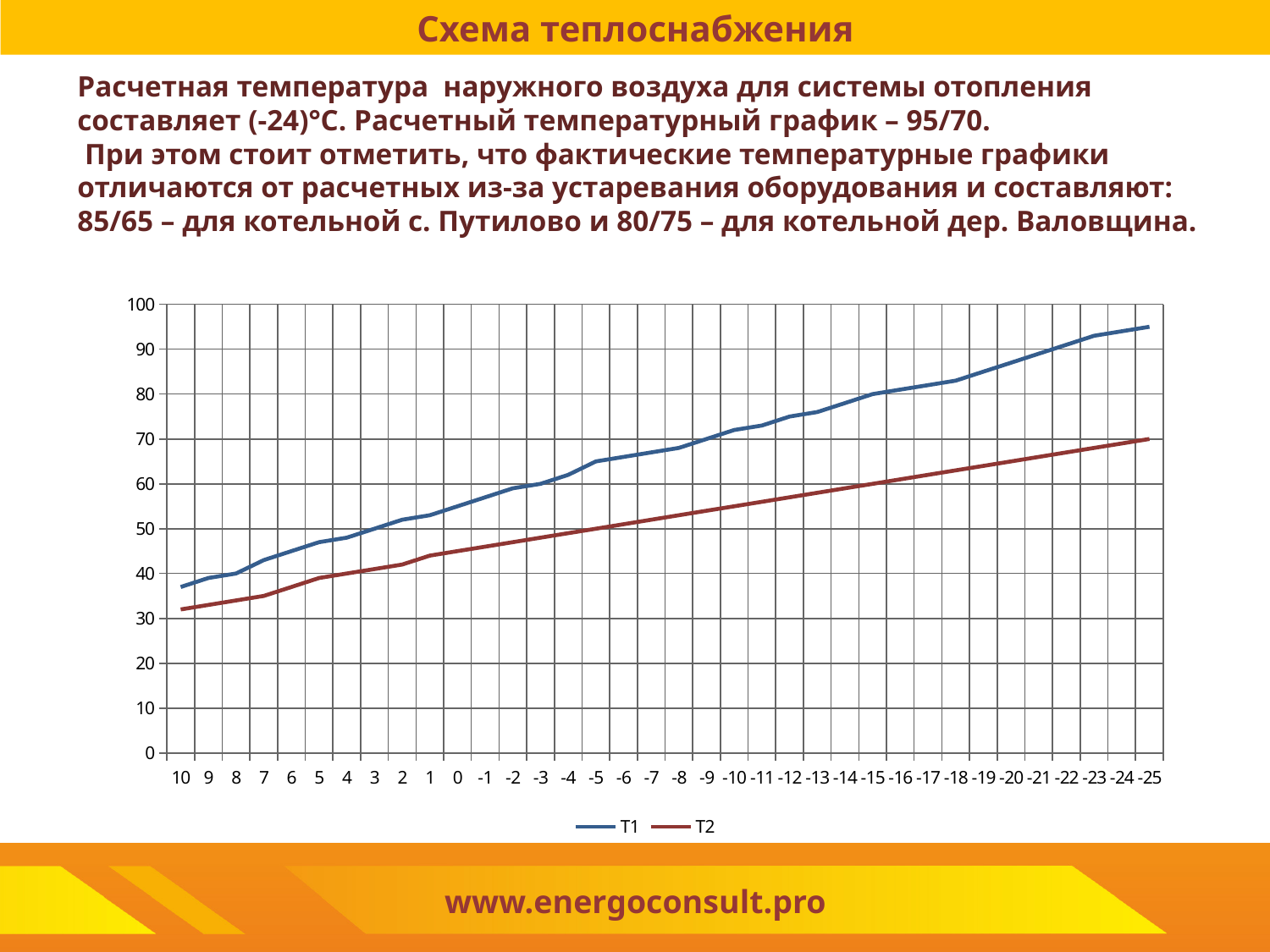
What is the value of T2 at -25? 70 Which series has the larger value at -25, T1 or T2? T1 What kind of chart is shown on the slide? line chart How many series does the legend list? 2 Is the value of T1 at -25 greater or less than 90? greater What are the names of the series in the legend? T1 and T2 Do the values of T1 rise or fall moving along the x axis from 10 to -25? rise Is the value of T1 at -10 greater or less than 70? greater How many points are on the x axis of the chart? 36 Is the value of T1 at 10 greater or less than 40? less At which x-axis value does T1 reach its highest point? -25